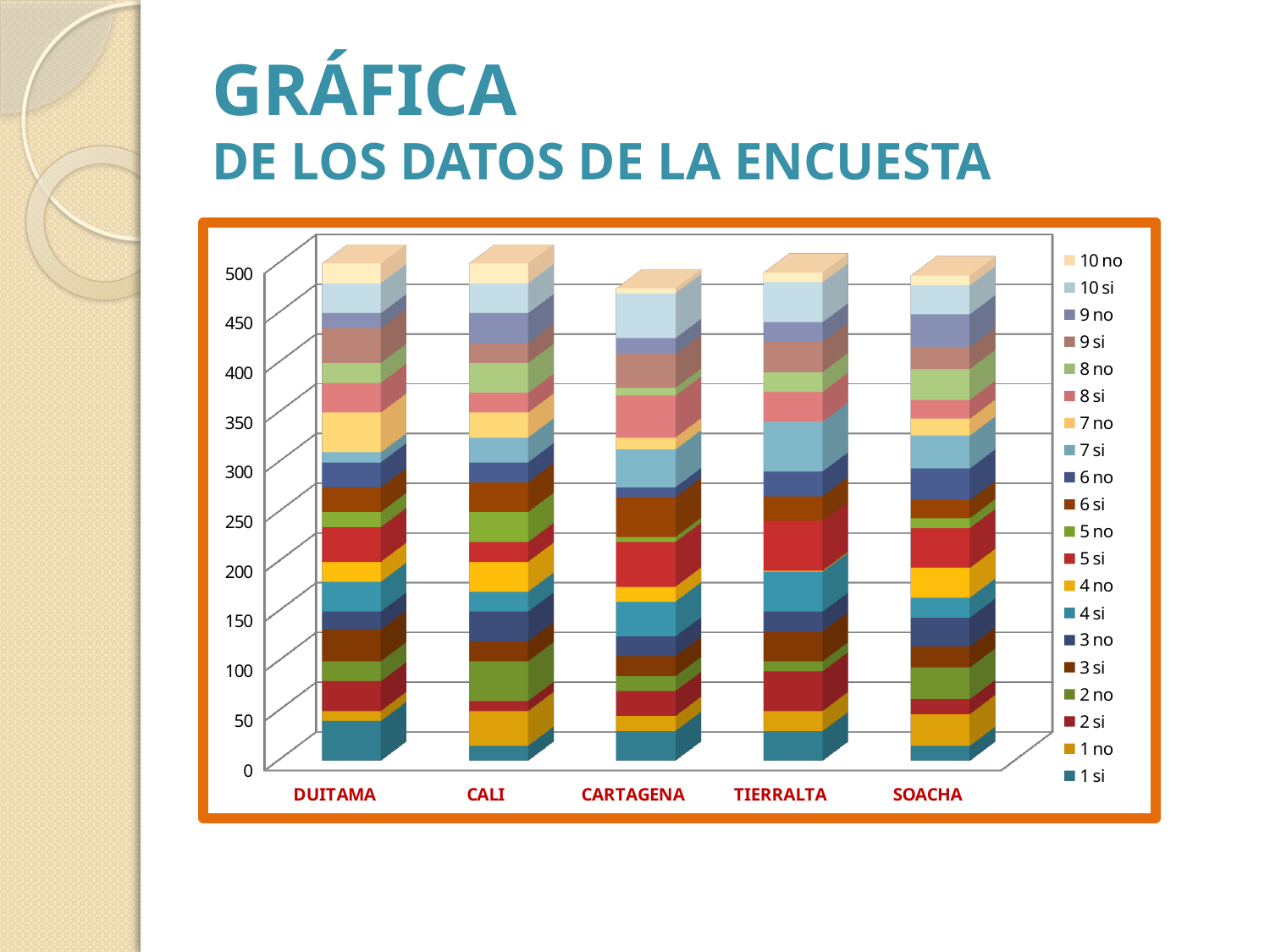
Which city has the lowest total stacked bar? CARTAGENA What is the title of the slide containing the chart? GRÁFICA DE LOS DATOS DE LA ENCUESTA Is the total stacked value for SOACHA greater or less than 300? greater Which category label appears first (leftmost) on the x axis? DUITAMA Is the total stacked value for CARTAGENA greater or less than 400? greater Is the total stacked value for DUITAMA greater or less than 400? greater What kind of chart is shown on the slide? Stacked bar chart Which is larger, the total stacked bar for CALI or for CARTAGENA? CALI What is the highest value shown on the vertical axis of the chart? 500 How many series does the chart's legend list? 20 How many cities (categories) are shown on the x axis of the chart? 5